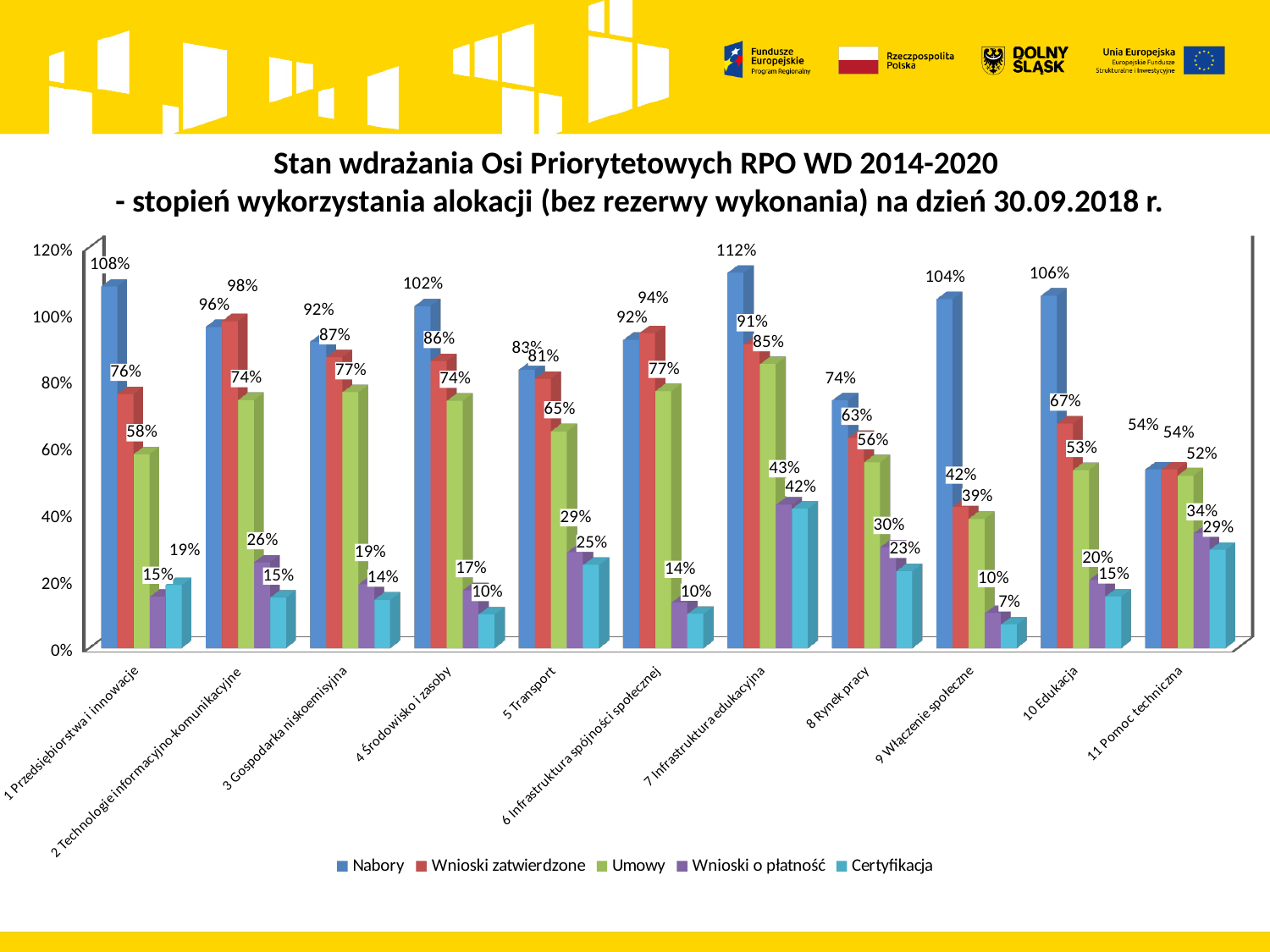
Which is larger for 8 Rynek pracy: Umowy or Wnioski o płatność? Umowy How many categories are shown on the x axis? 11 What is the Certyfikacja value for 5 Transport? 25% Which category has the highest Nabory value? 7 Infrastruktura edukacyjna What is the Umowy value for 9 Włączenie społeczne? 39% Is the Wnioski zatwierdzone value for 10 Edukacja greater or less than 60%? greater What is the Wnioski o płatność value for 2 Technologie informacyjno-komunikacyjne? 26% What is the Nabory value for 7 Infrastruktura edukacyjna? 112% What kind of chart is shown on the slide? Bar chart What is the difference between the Nabory and Wnioski zatwierdzone values for 9 Włączenie społeczne? 62% How many series does the legend list? 5 Which category has the lowest Certyfikacja value? 9 Włączenie społeczne